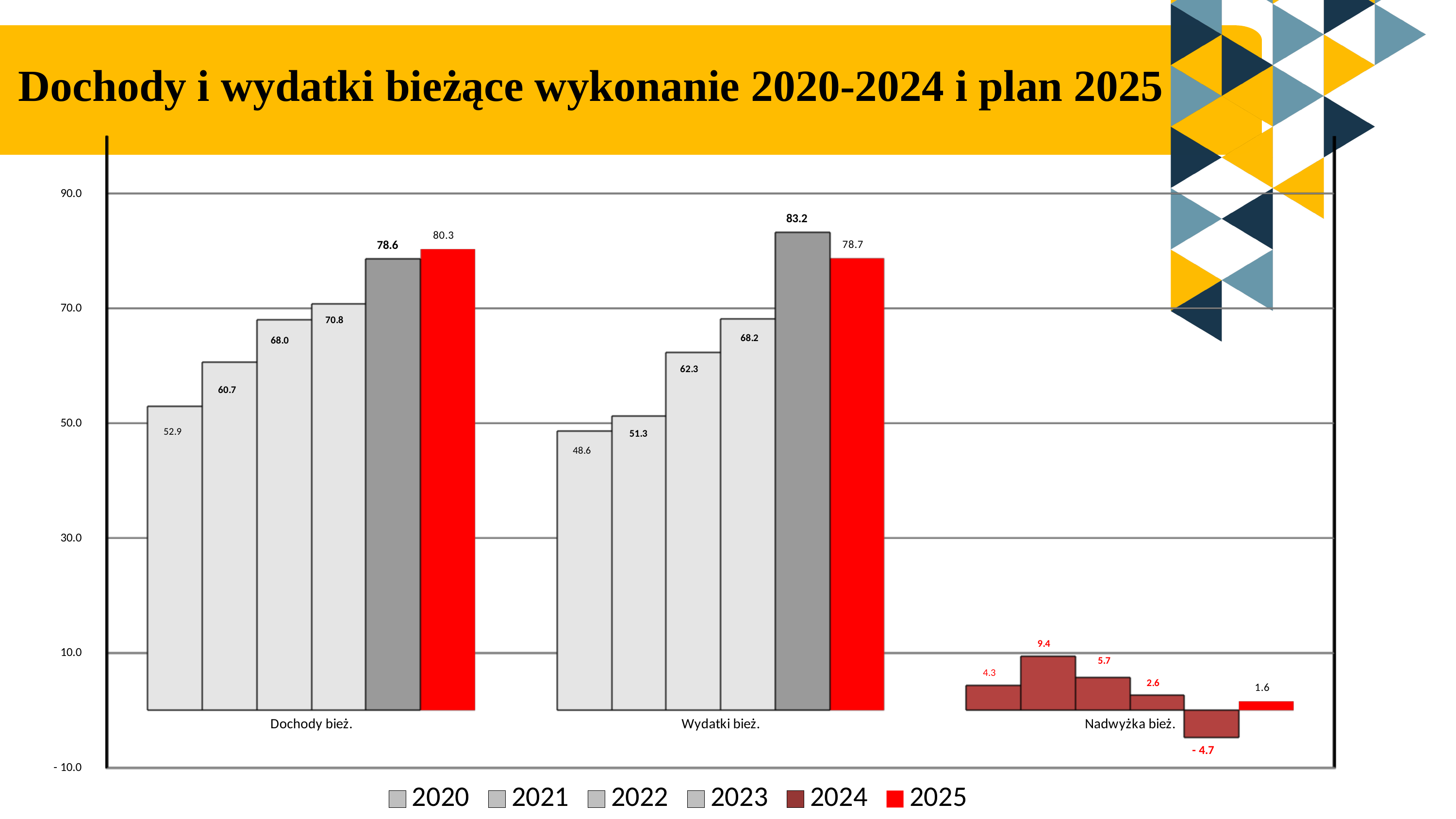
How many categories are shown on the x axis? 3 Which is larger in 2024: Dochody bież. or Wydatki bież.? Wydatki bież. What is the difference between the 2025 and 2020 values in the Dochody bież. category? 27.4 What is the value for 2024 in the Nadwyżka bież. category? - 4.7 How many series does the legend list? 6 Which year has the highest value in the Nadwyżka bież. category? 2021 Do the values in the Dochody bież. category rise or fall from 2020 to 2025? rise What is the value for 2025 in the Dochody bież. category? 80.3 What is the value for 2024 in the Wydatki bież. category? 83.2 Which year has the lowest value in the Dochody bież. category? 2020 What kind of chart is shown on the slide? bar chart Is the 2022 value for Wydatki bież. greater or less than 70.0? less